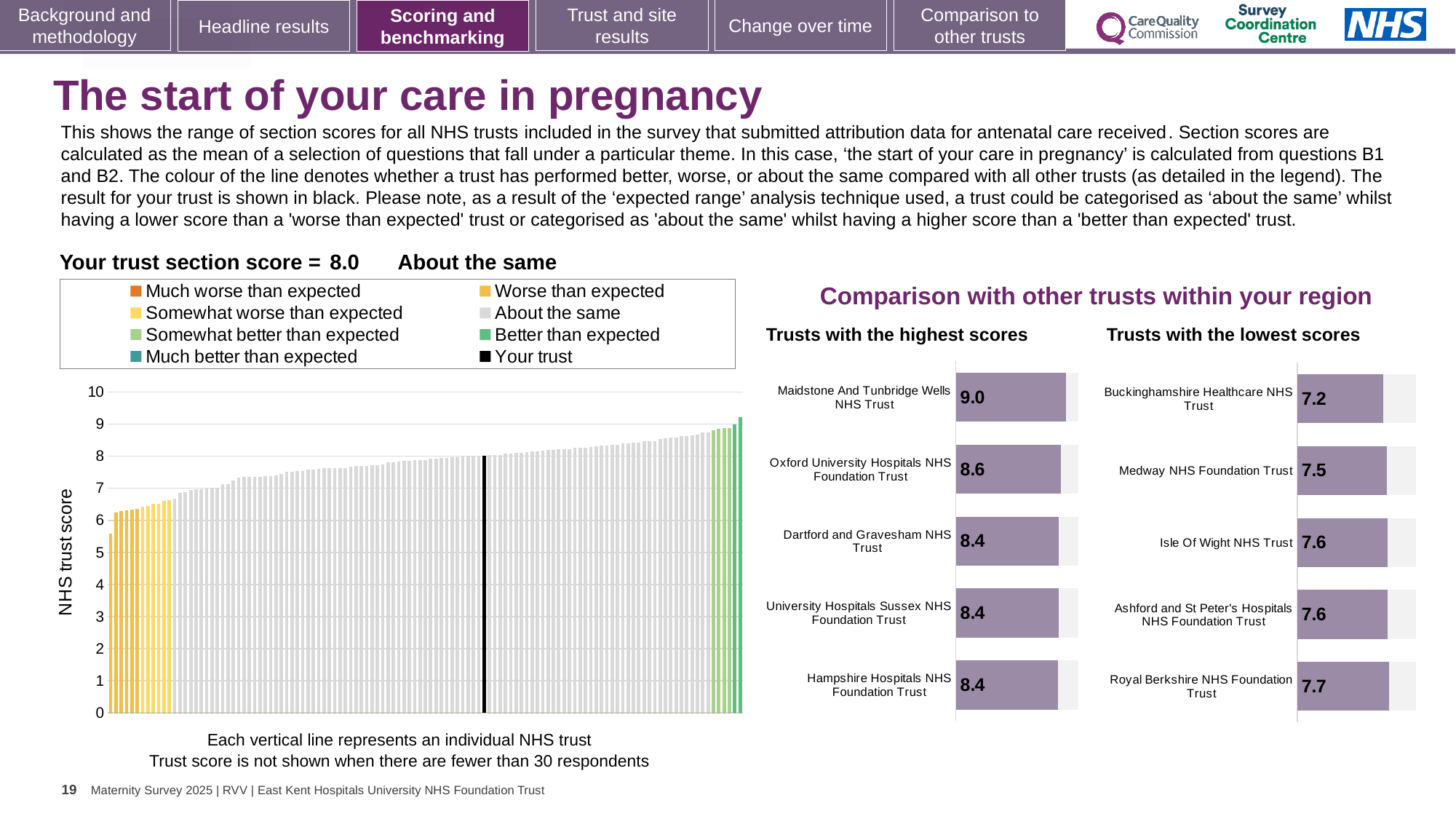
In the 'Trusts with the highest scores' chart, what is the score for Oxford University Hospitals NHS Foundation Trust? 8.6 In the 'Trusts with the lowest scores' chart, what is the score for Royal Berkshire NHS Foundation Trust? 7.7 How many trusts are shown in the 'Trusts with the lowest scores' chart? 5 In the 'Trusts with the lowest scores' chart, what is the score for Buckinghamshire Healthcare NHS Trust? 7.2 In the large chart on the left, is the value of the lowest (leftmost) bar greater or less than 6? less In the large chart on the left, do the bar values rise or fall from left to right? rise In the 'Trusts with the highest scores' chart, what is the score for Maidstone And Tunbridge Wells NHS Trust? 9.0 What kind of chart is the large chart on the left with the y-axis labelled 'NHS trust score'? bar chart In the 'Trusts with the highest scores' chart, which trust has the highest score? Maidstone And Tunbridge Wells NHS Trust In the 'Trusts with the lowest scores' chart, which has the larger score: Medway NHS Foundation Trust or Royal Berkshire NHS Foundation Trust? Royal Berkshire NHS Foundation Trust In the 'Trusts with the highest scores' chart, what is the difference between the scores of Maidstone And Tunbridge Wells NHS Trust and Oxford University Hospitals NHS Foundation Trust? 0.4 In the 'Trusts with the lowest scores' chart, which trust has the lowest score? Buckinghamshire Healthcare NHS Trust